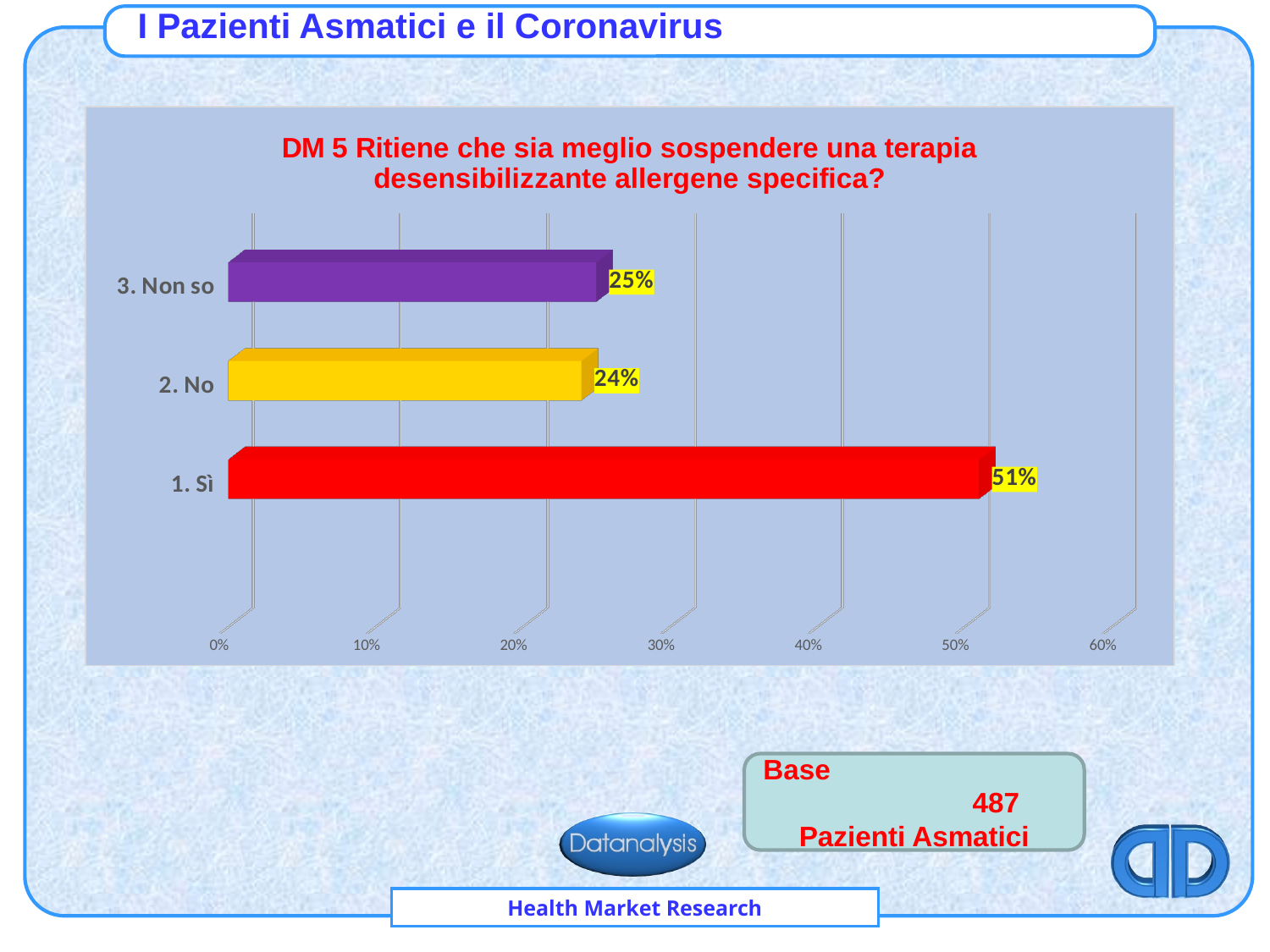
What is the value for "3. Non so"? 25% What kind of chart is shown on the slide? bar chart How many categories are shown in the chart? 3 Is the value for "1. Sì" greater or less than 40%? greater What colour is the bar for "2. No"? yellow What is the value for "2. No"? 24% What is the difference between the values for "3. Non so" and "2. No"? 1% Which is larger, the value for "1. Sì" or the value for "3. Non so"? 1. Sì What is the value for "1. Sì"? 51% Which category has the lowest value? 2. No What is the difference between the values for "1. Sì" and "2. No"? 27% Which category has the highest value? 1. Sì